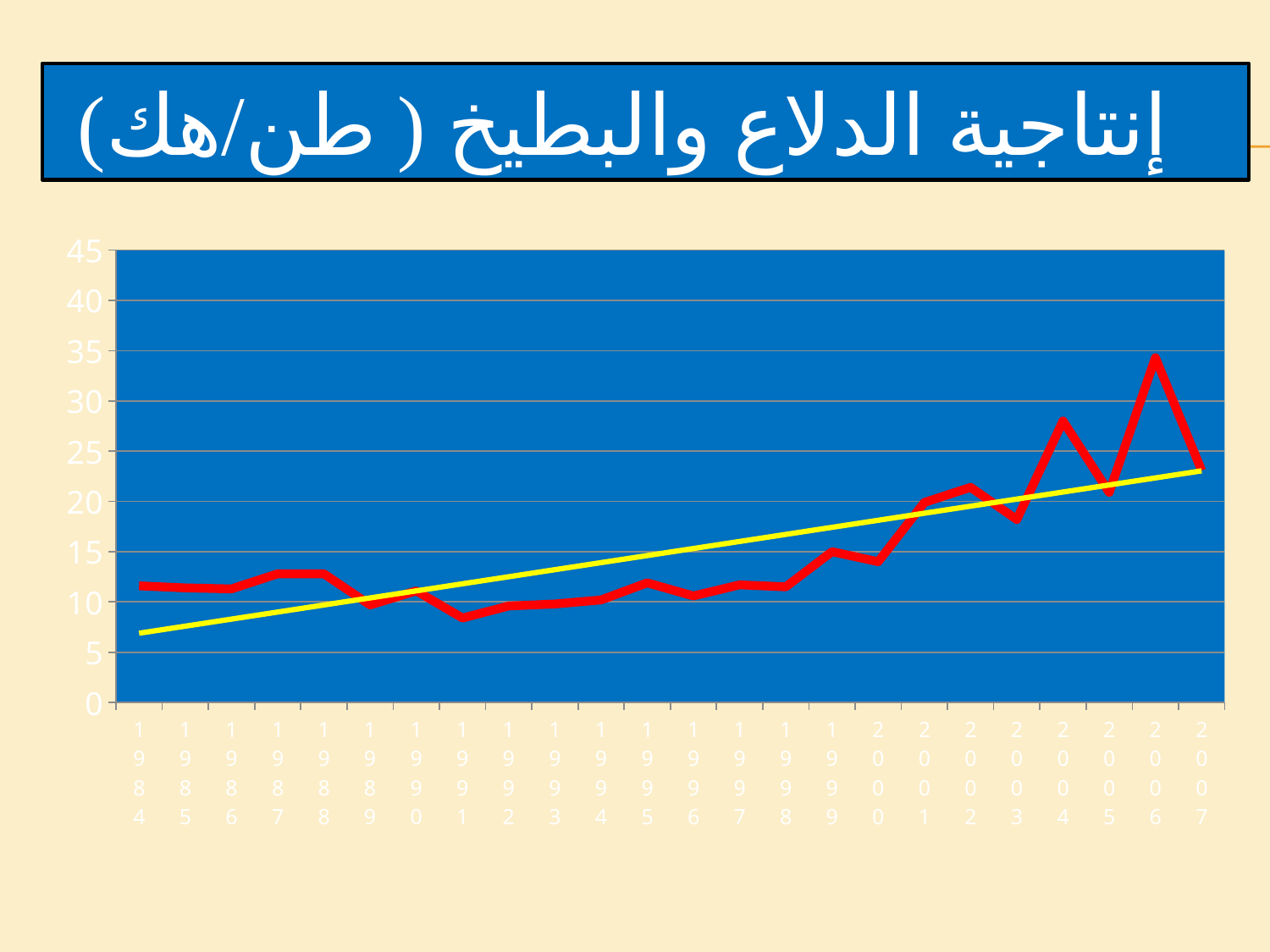
Is the value for 1984 greater or less than 10? greater Does the red line generally rise or fall from 1984 to 2007? rise What is the title of the chart? إنتاجية الدلاع والبطيخ ( طن/هك) Is the value for 2006 greater or less than 30? greater Is the value for 2000 greater or less than 20? less Which year has the larger value, 2006 or 2004? 2006 Which year has the highest value on the red line? 2006 What kind of chart is shown on the slide? line chart Which year has the lowest value on the red line? 1991 How many years are plotted along the x axis? 24